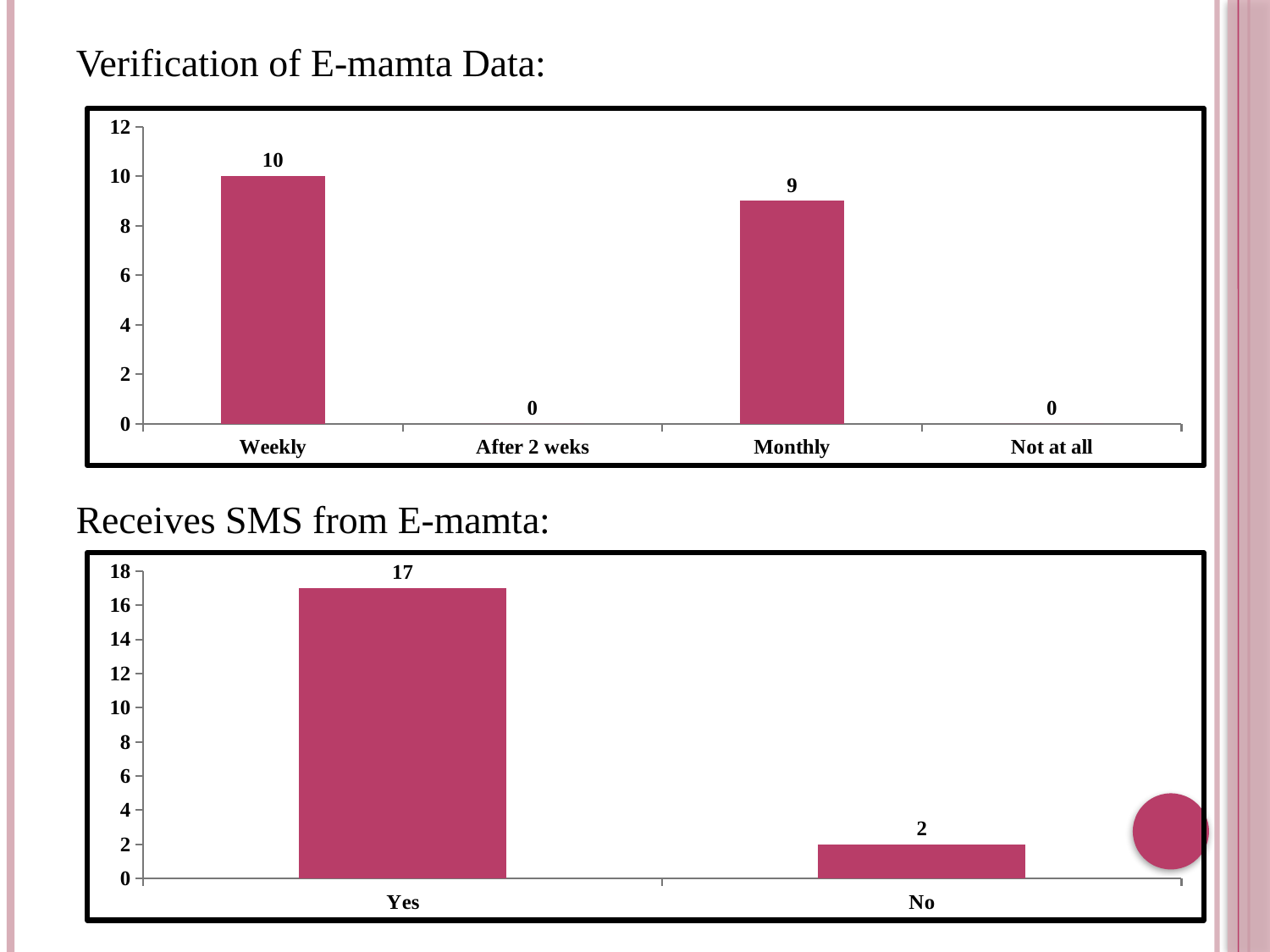
In the 'Receives SMS from E-mamta' chart, which category has the lowest value? No In the 'Verification of E-mamta Data' chart, what is the difference between the Weekly and Monthly values? 1 In the 'Verification of E-mamta Data' chart, what is the value for After 2 weks? 0 In the 'Receives SMS from E-mamta' chart, what is the value for No? 2 In the 'Verification of E-mamta Data' chart, what is the value for Weekly? 10 What kind of chart is the 'Verification of E-mamta Data' chart? Bar chart In the 'Receives SMS from E-mamta' chart, what is the value for Yes? 17 In the 'Verification of E-mamta Data' chart, which category has the highest value? Weekly In the 'Receives SMS from E-mamta' chart, what is the difference between the Yes and No values? 15 In the 'Receives SMS from E-mamta' chart, is the value for Yes greater or less than 16? greater In the 'Verification of E-mamta Data' chart, what is the value for Monthly? 9 In the 'Verification of E-mamta Data' chart, how many categories are shown on the x axis? 4